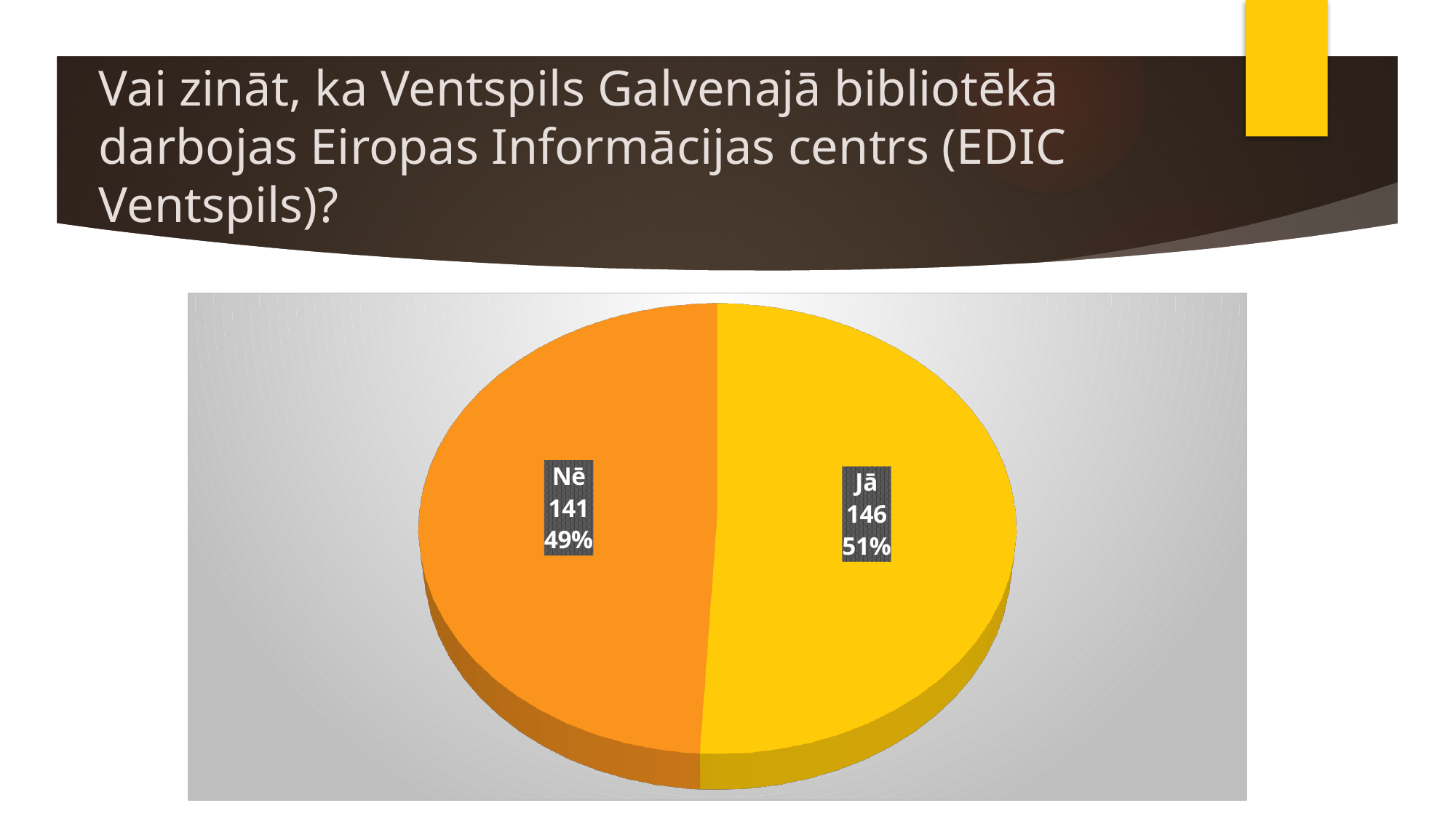
What is the total of the two slices? 287 What kind of chart is shown on the slide? pie chart What is the value for Nē? 141 What share of the pie does Jā represent? 51% What share of the pie does Nē represent? 49% What colour is the Nē slice? orange What colour is the Jā slice? yellow What is the value for Jā? 146 Which slice is the smallest? Nē How many slices does the pie chart have? 2 What is the difference between the values for Jā and Nē? 5 Which slice has the larger value, Jā or Nē? Jā